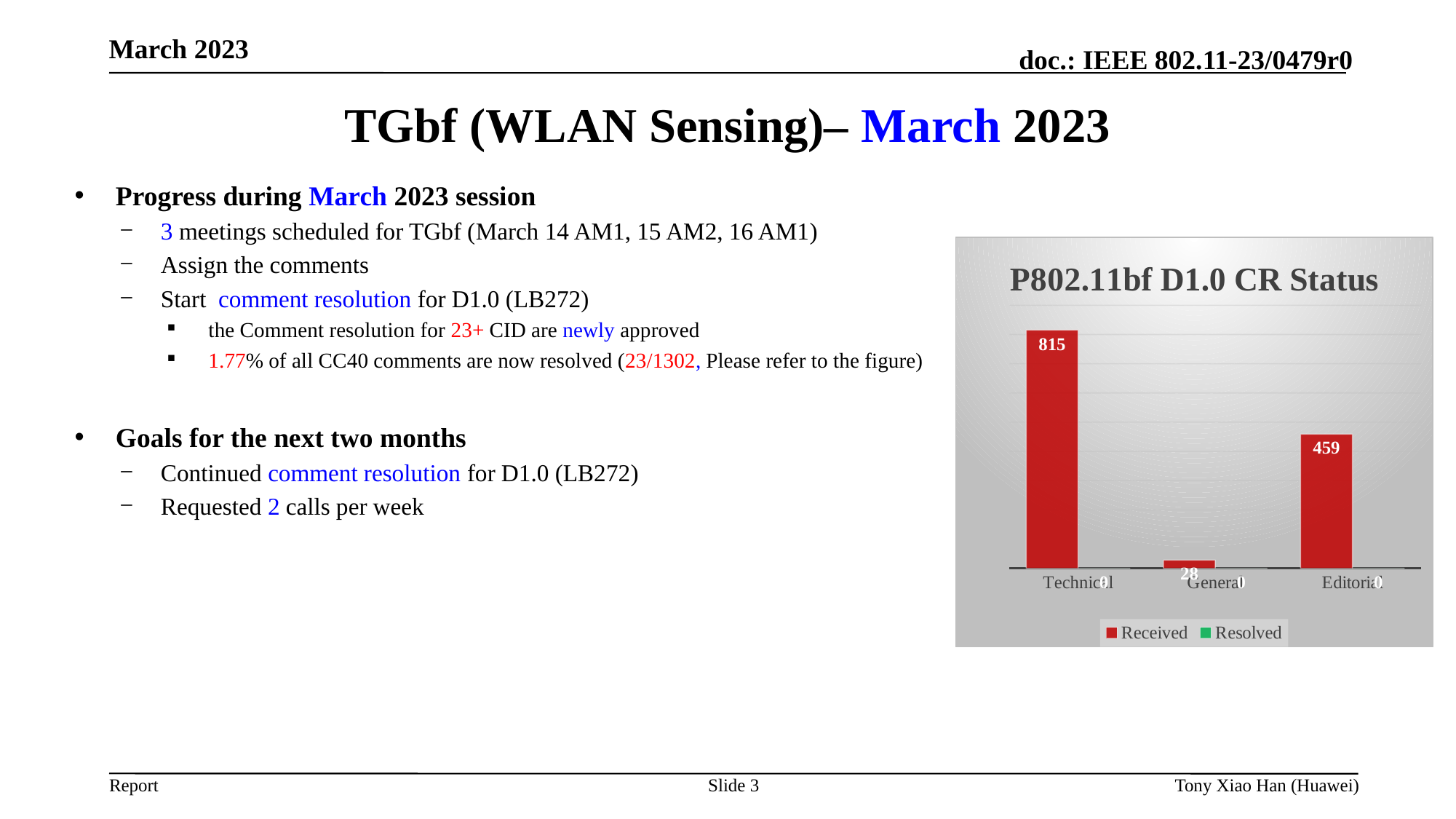
Which category has the lowest Received value? General What is the Received value for Editorial? 459 What is the Received value for General? 28 What is the difference between the Received values for Technical and Editorial? 356 What type of chart is shown on the slide? bar chart Which category has the highest Received value? Technical What is the Received value for Technical? 815 How many categories are shown on the x axis of the chart? 3 Which has a larger Received value, General or Editorial? Editorial What are the series names in the chart legend? Received, Resolved How many series does the chart legend list? 2 What is the title of the chart? P802.11bf D1.0 CR Status